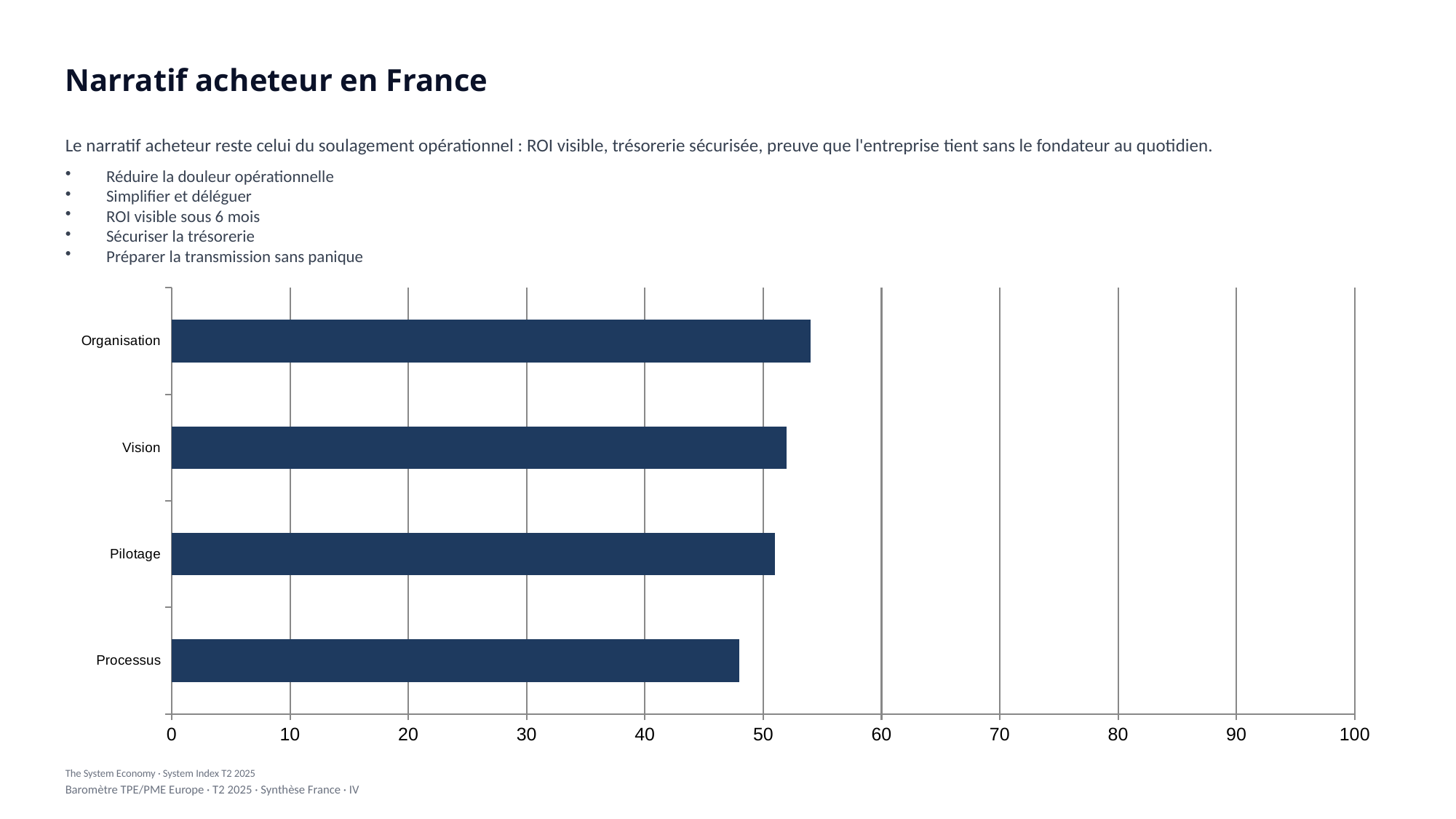
What is the maximum value shown on the horizontal axis? 100 Which category has the highest value? Organisation Is the value for Processus greater or less than 40? greater Is the value for Organisation greater or less than 60? less How many categories does the chart show? 4 Is the value for Organisation greater or less than 50? greater Which is larger, the value for Vision or the value for Processus? Vision What kind of chart is shown on the slide? bar chart Which is larger, the value for Organisation or the value for Processus? Organisation Which category has the lowest value? Processus